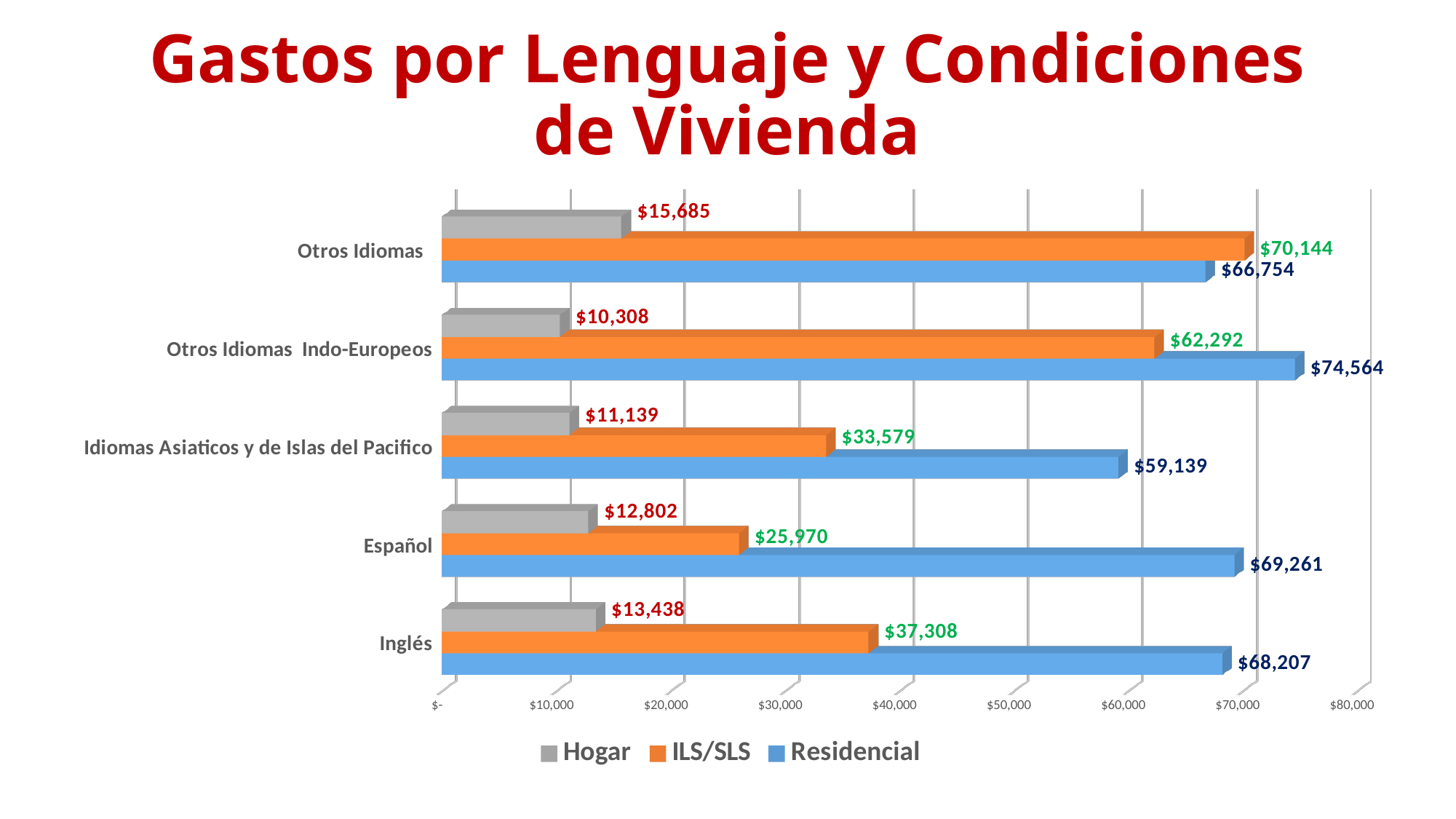
What is the ILS/SLS value for Idiomas Asiaticos y de Islas del Pacifico? $33,579 What is the title of the chart? Gastos por Lenguaje y Condiciones de Vivienda Which category has the lowest ILS/SLS value? Español Which category has the lowest Hogar value? Otros Idiomas Indo-Europeos What is the Residencial value for Español? $69,261 What is the Hogar value for Otros Idiomas? $15,685 What kind of chart is shown on the slide? Bar chart How many language categories are shown on the chart? 5 Which is larger for Otros Idiomas: the ILS/SLS value or the Residencial value? ILS/SLS How many series does the legend list? 3 What is the difference between the Residencial and ILS/SLS values for Inglés? $30,899 Which category has the highest Residencial value? Otros Idiomas Indo-Europeos